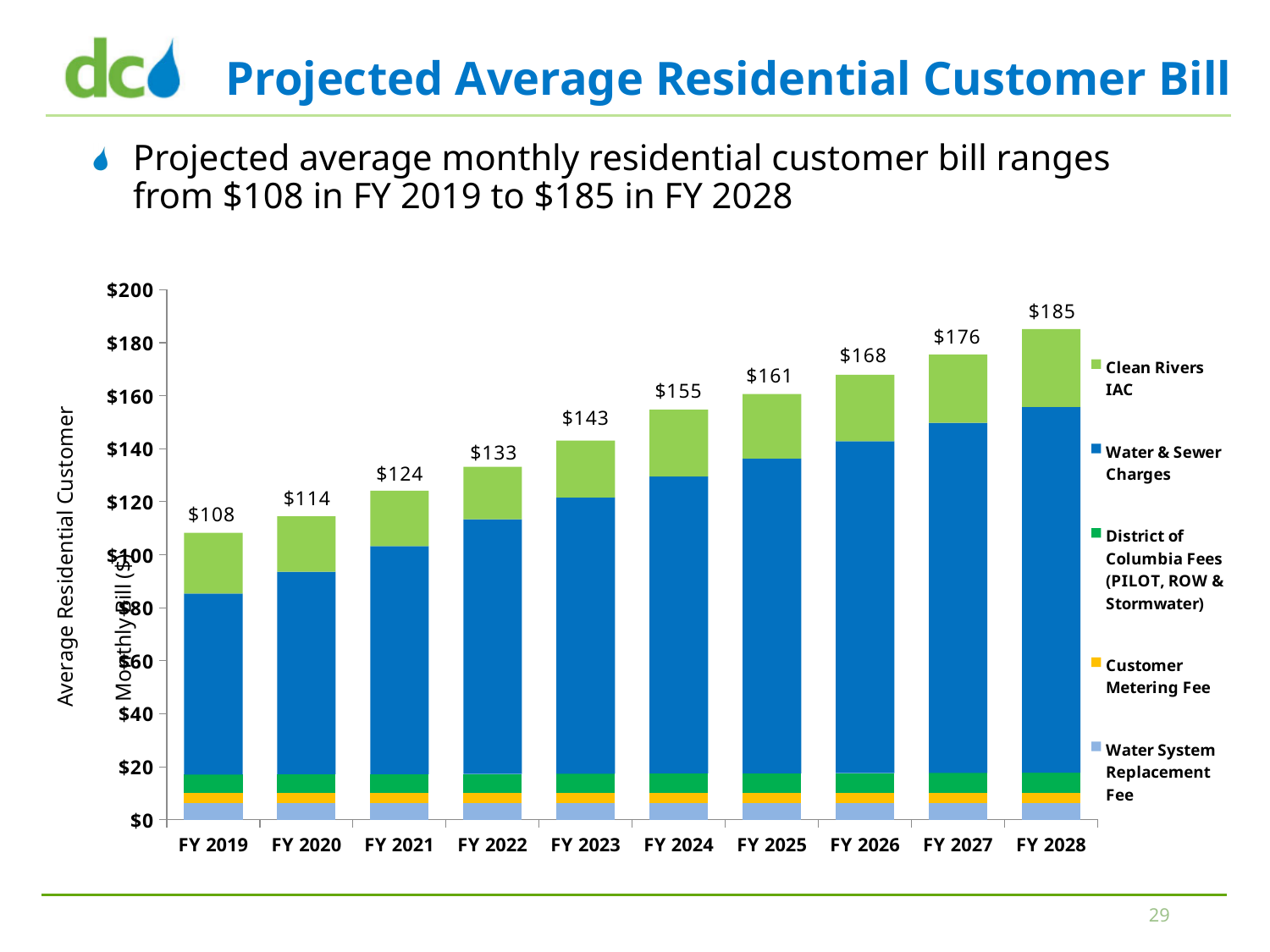
What is the difference between the total bill in FY 2028 and the total bill in FY 2019? $77 How many series does the legend list? 5 What is the total projected average residential customer bill for FY 2020? $114 What is the total projected average residential customer bill for FY 2023? $143 Which fiscal year has the lowest total projected bill? FY 2019 What kind of chart is shown on the slide? Stacked bar chart Which fiscal year has the highest total projected bill? FY 2028 What is the difference between the total bill in FY 2025 and the total bill in FY 2024? $6 Which is larger, the total bill in FY 2022 or the total bill in FY 2026? FY 2026 Do the total projected bills rise or fall from FY 2019 to FY 2028? Rise How many fiscal years are shown on the x axis? 10